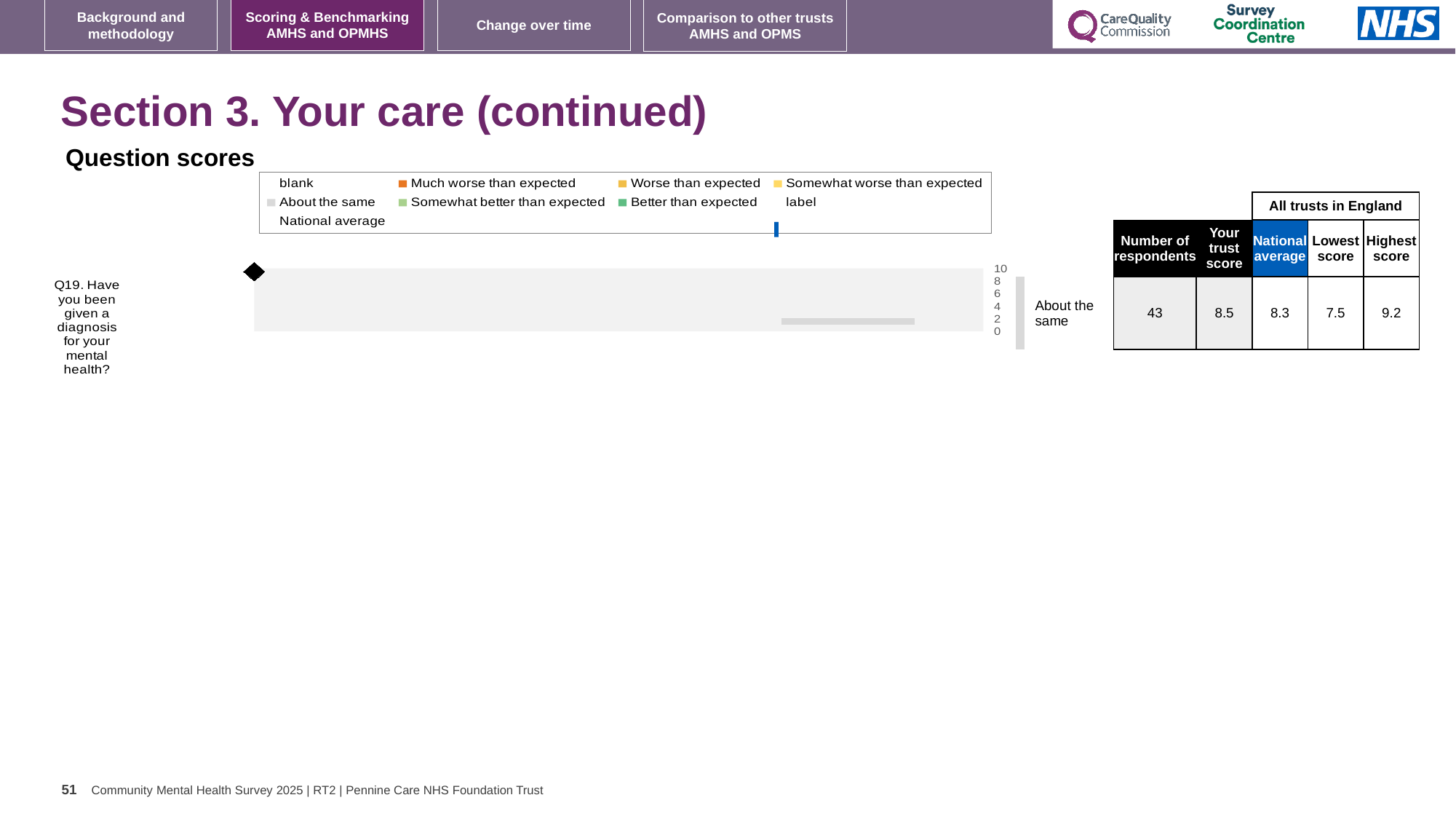
For Q19, which is larger: the trust score or the national average? the trust score What is the national average score for Q19? 8.3 How many respondents answered Q19? 43 What benchmark category is shown for Q19 next to the chart? About the same What is the highest score among all trusts in England for Q19? 9.2 What kind of chart is used to show the question scores on this slide? bar chart For Q19, what is the difference between the trust score and the national average? 0.2 Which question is plotted in the question scores chart? Q19. Have you been given a diagnosis for your mental health? For Q19, what is the difference between the highest and lowest scores among all trusts in England? 1.7 What is the trust score for Q19? 8.5 How many questions are plotted in the question scores chart? 1 What is the lowest score among all trusts in England for Q19? 7.5